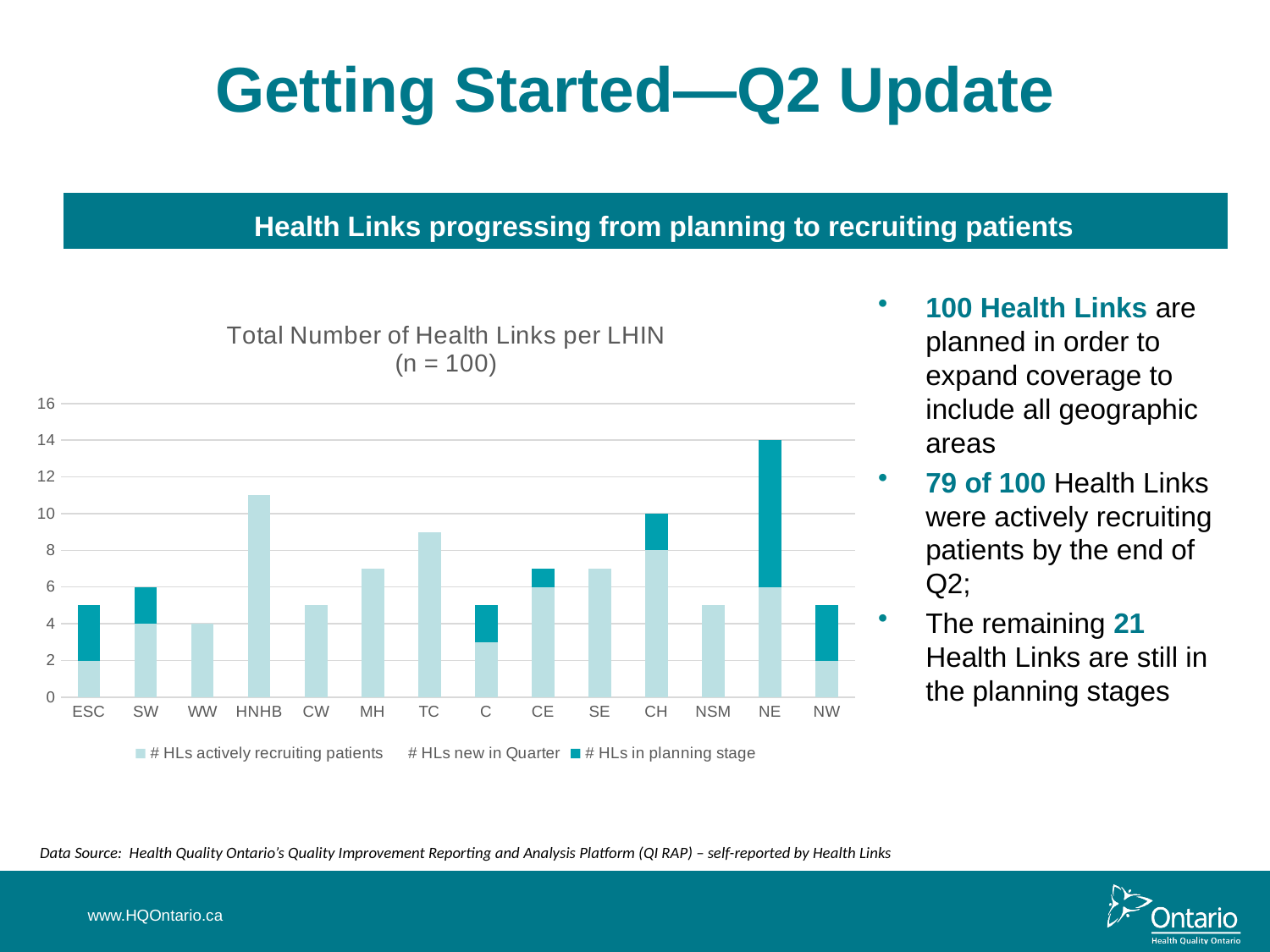
What kind of chart is shown on the slide? bar chart Is the total number of Health Links for MH greater or less than 8? less How many HLs are actively recruiting patients in CH? 8 What is the total number of Health Links for NE? 14 Which LHIN has the highest total number of Health Links? NE Is the total number of Health Links for HNHB greater or less than 10? greater What is the title of the chart? Total Number of Health Links per LHIN (n = 100) How many series does the chart legend list? 3 What is the total number of Health Links for WW? 4 Which has a larger total number of Health Links, NE or CH? NE How many LHIN categories are shown on the x axis of the chart? 14 What is the total number of Health Links for CH? 10